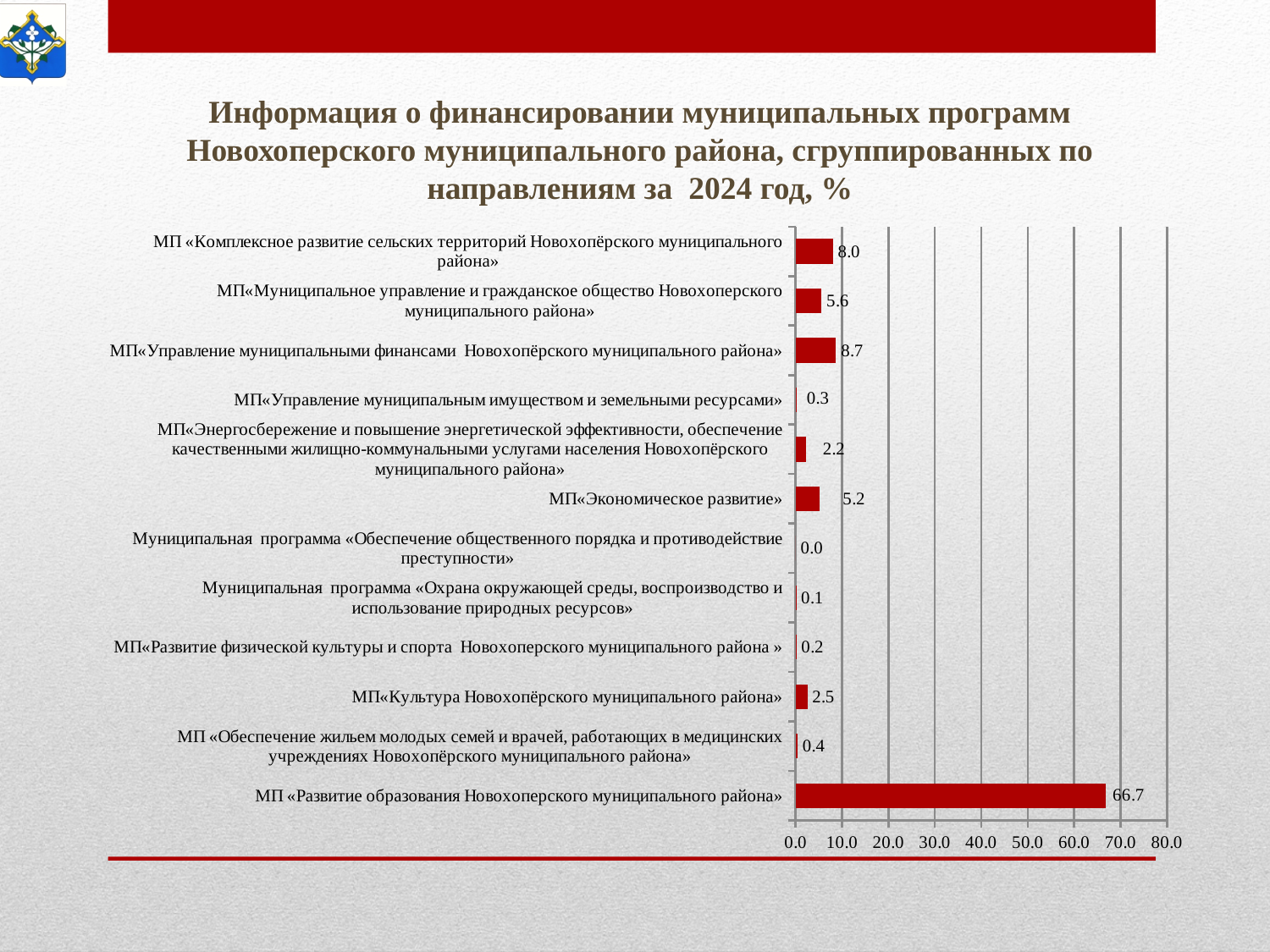
Which is larger: the value for МП«Муниципальное управление и гражданское общество Новохоперского муниципального района» or the value for МП«Экономическое развитие»? МП«Муниципальное управление и гражданское общество Новохоперского муниципального района» Which programme has the highest value in the chart? МП «Развитие образования Новохоперского муниципального района» What type of chart is shown on the slide? bar chart Is the value for МП «Развитие образования Новохоперского муниципального района» greater or less than 60.0? greater What is the value for МП«Управление муниципальными финансами Новохопёрского муниципального района»? 8.7 What is the value for МП «Развитие образования Новохоперского муниципального района»? 66.7 Which programme has the lowest value in the chart? Муниципальная программа «Обеспечение общественного порядка и противодействие преступности» What is the value for МП«Экономическое развитие»? 5.2 What is the value for МП«Культура Новохопёрского муниципального района»? 2.5 What is the difference between the values for МП«Управление муниципальными финансами Новохопёрского муниципального района» and МП «Комплексное развитие сельских территорий Новохопёрского муниципального района»? 0.7 How many categories (programmes) are plotted in the chart? 12 What is the maximum value shown on the horizontal axis of the chart? 80.0